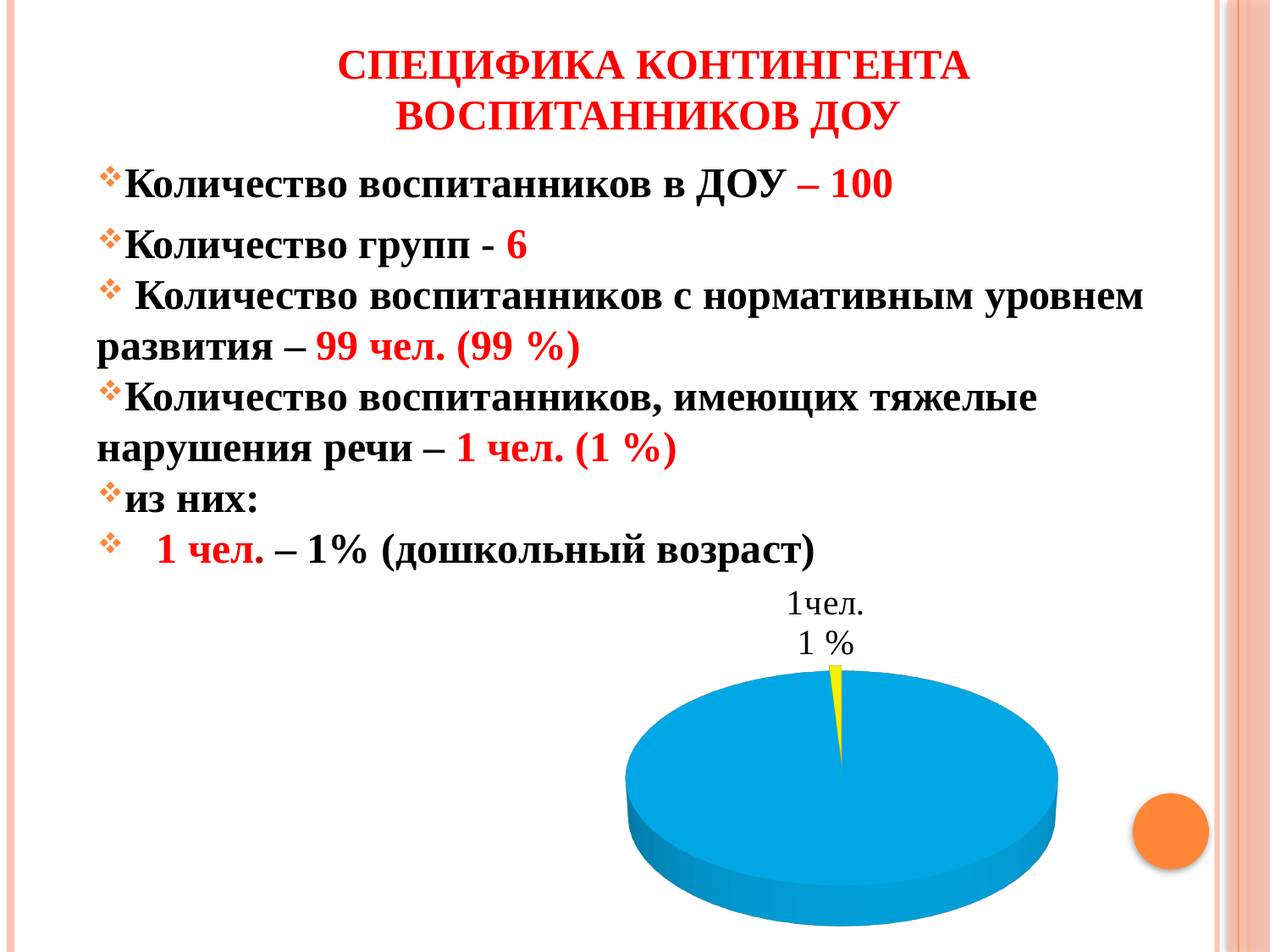
What kind of chart is shown on the slide? pie chart Is the blue slice of the pie chart greater or less than 50% of the pie? greater Which colour slice is the largest in the pie chart? blue Is the pie chart drawn in 3D or flat 2D? 3D How many slices does the pie chart have? 2 How many people does the yellow slice of the pie chart represent? 1чел. Does the pie chart have a legend? No Which colour slice is the smallest in the pie chart? yellow Which slice is larger in the pie chart, the blue one or the yellow one? the blue one What data label is printed on the small yellow slice of the pie chart? 1чел. 1 % What share of the pie does the yellow slice represent? 1 %